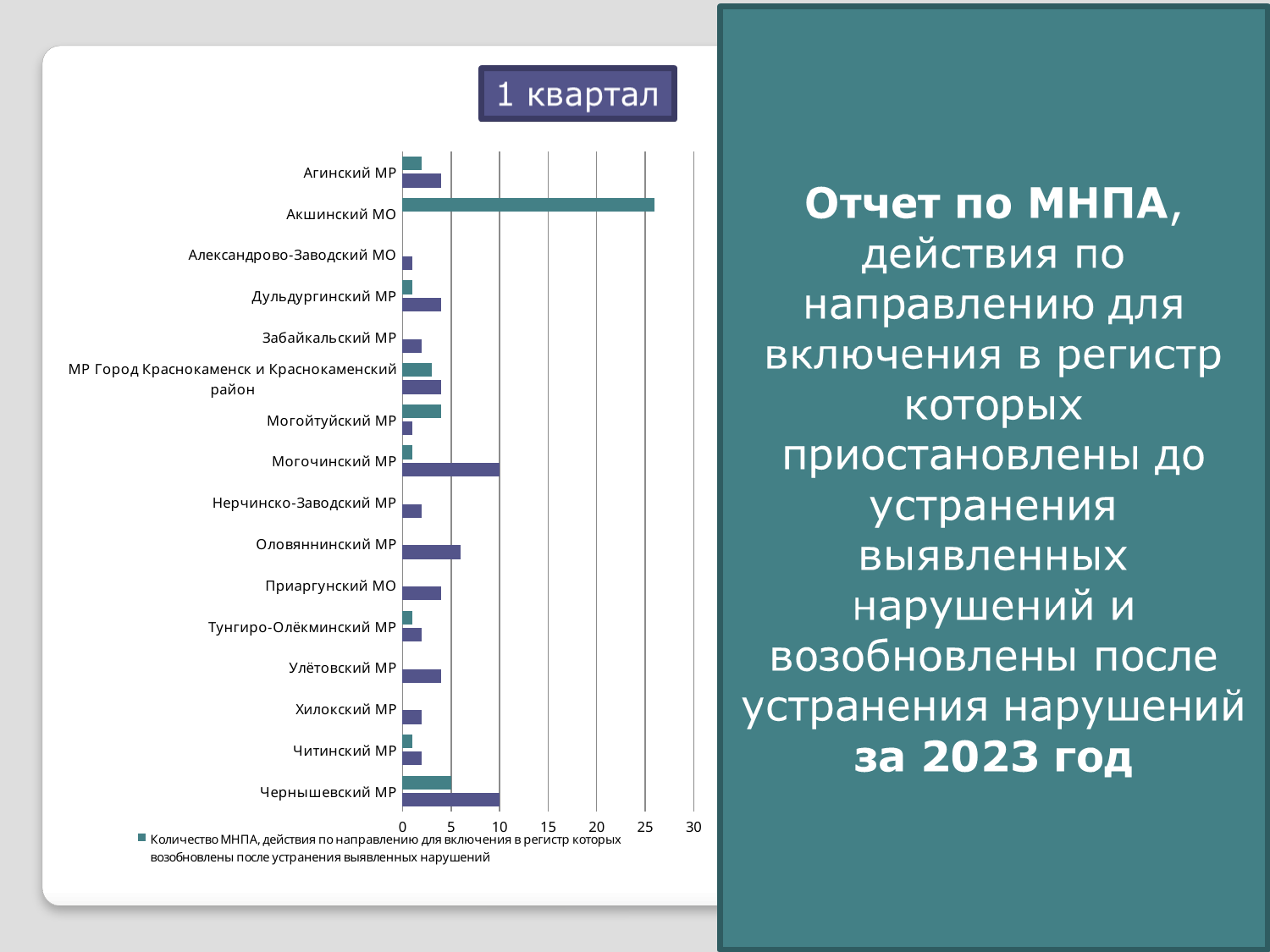
What is the value of the teal bar for Чернышевский МР? 5 What kind of chart is shown on the slide? bar chart Is the value of the teal bar for Акшинский МО greater or less than 20? greater What is the value of the purple bar for Чернышевский МР? 10 Which category has the longest bar on the chart? Акшинский МО What is the highest value shown on the horizontal axis of the chart? 30 How many municipal districts (categories) are listed on the chart's vertical axis? 16 Is the value of the purple bar for Улётовский МР greater or less than 5? less Is the value of the purple bar for Оловяннинский МР greater or less than 5? greater What is the value of the purple bar for Могочинский МР? 10 Which is larger: the purple bar for Могочинский МР or the purple bar for Оловяннинский МР? Могочинский МР What is the title shown above the chart? 1 квартал